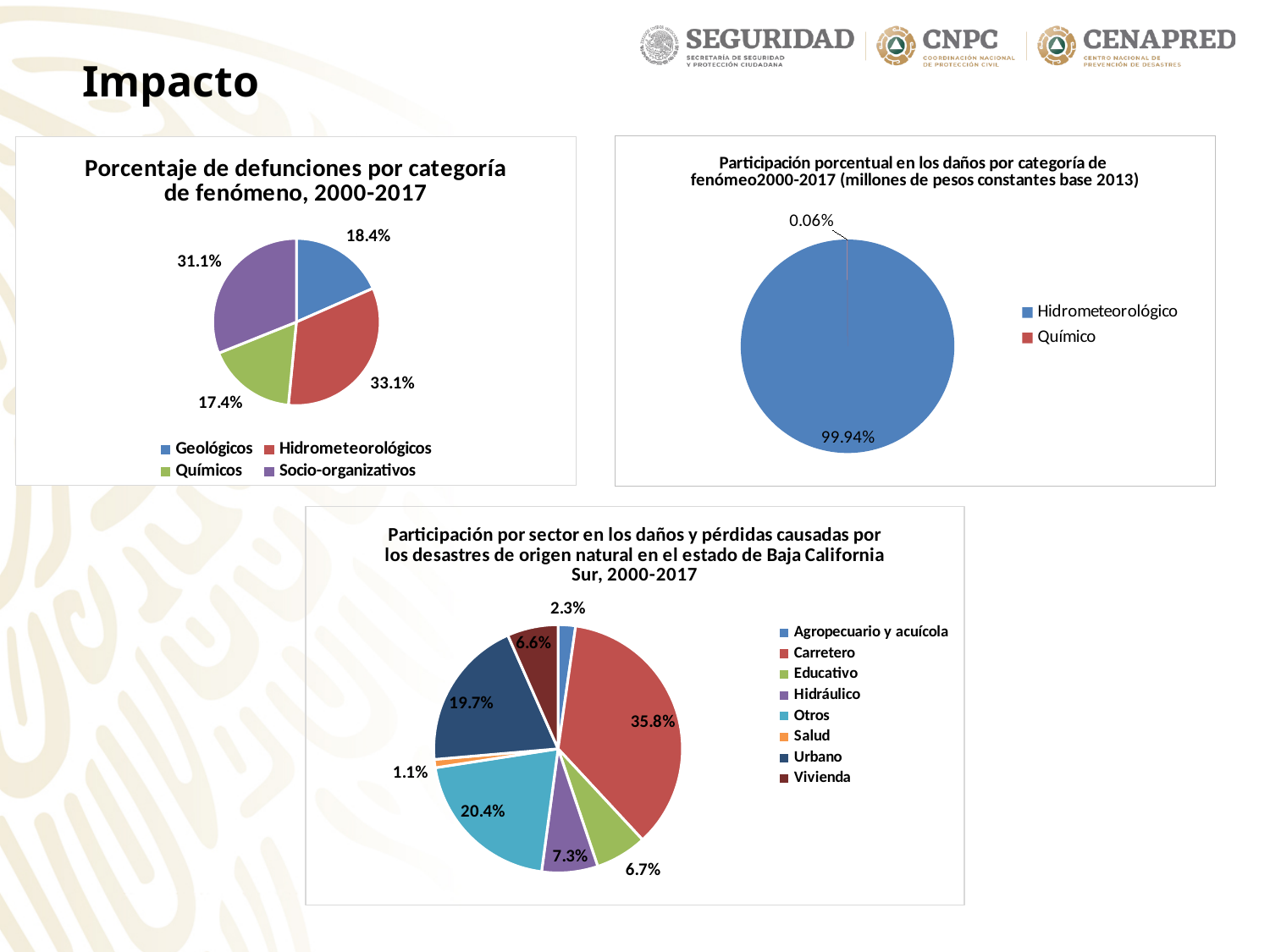
In the top-right chart 'Participación porcentual en los daños por categoría de fenómeo 2000-2017', which category has the largest share? Hidrometeorológico In the top-right chart 'Participación porcentual en los daños por categoría de fenómeo 2000-2017', what percentage is shown for Químico? 0.06% In the top-left chart 'Porcentaje de defunciones por categoría de fenómeno, 2000-2017', what percentage is shown for Hidrometeorológicos? 33.1% In the bottom chart 'Participación por sector en los daños y pérdidas...Baja California Sur, 2000-2017', which sector has the smallest share? Salud In the bottom chart 'Participación por sector en los daños y pérdidas...Baja California Sur, 2000-2017', what percentage is shown for Carretero? 35.8% In the bottom chart 'Participación por sector en los daños y pérdidas...Baja California Sur, 2000-2017', which is larger, Otros or Urbano? Otros In the top-left chart 'Porcentaje de defunciones por categoría de fenómeno, 2000-2017', what is the difference between the Socio-organizativos and Geológicos shares? 12.7% In the bottom chart 'Participación por sector en los daños y pérdidas...Baja California Sur, 2000-2017', what colour is the Vivienda slice? Dark red In the top-left chart 'Porcentaje de defunciones por categoría de fenómeno, 2000-2017', how many categories does the legend list? 4 In the bottom chart 'Participación por sector en los daños y pérdidas...Baja California Sur, 2000-2017', how many sectors does the legend list? 8 In the top-left chart 'Porcentaje de defunciones por categoría de fenómeno, 2000-2017', which category has the smallest share? Químicos What type of chart is the bottom chart 'Participación por sector en los daños y pérdidas causadas por los desastres de origen natural en el estado de Baja California Sur, 2000-2017'? Pie chart